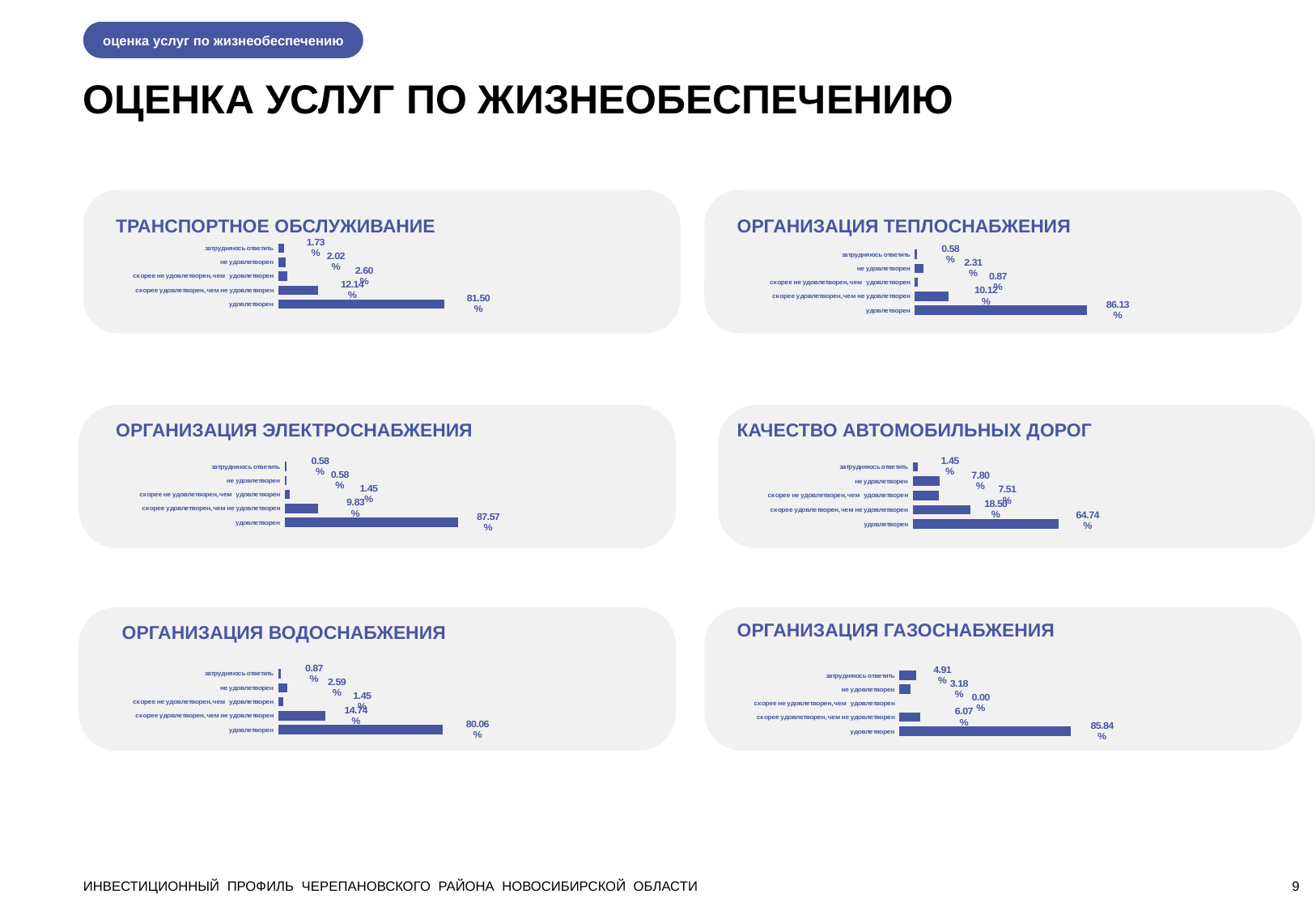
How many charts are shown on the slide? 6 In the chart titled "ОРГАНИЗАЦИЯ ВОДОСНАБЖЕНИЯ", what is the difference between the values for "удовлетворен" and "скорее удовлетворен, чем не удовлетворен"? 65.32 % How many categories does the chart titled "ОРГАНИЗАЦИЯ ТЕПЛОСНАБЖЕНИЯ" show? 5 In the chart titled "ОРГАНИЗАЦИЯ ЭЛЕКТРОСНАБЖЕНИЯ", which category has the highest value? удовлетворен In the chart titled "ОРГАНИЗАЦИЯ ЭЛЕКТРОСНАБЖЕНИЯ", what is the difference between the values for "удовлетворен" and "скорее удовлетворен, чем не удовлетворен"? 77.74 % In the chart titled "ОРГАНИЗАЦИЯ ГАЗОСНАБЖЕНИЯ", what is the value for "скорее не удовлетворен, чем удовлетворен"? 0.00 % In the chart titled "КАЧЕСТВО АВТОМОБИЛЬНЫХ ДОРОГ", which is larger: the value for "не удовлетворен" or the value for "скорее удовлетворен, чем не удовлетворен"? скорее удовлетворен, чем не удовлетворен In the chart titled "ОРГАНИЗАЦИЯ ТЕПЛОСНАБЖЕНИЯ", what is the value for "скорее удовлетворен, чем не удовлетворен"? 10.12 % In the chart titled "КАЧЕСТВО АВТОМОБИЛЬНЫХ ДОРОГ", which category has the lowest value? затрудняюсь ответить What kind of chart is used in the "ТРАНСПОРТНОЕ ОБСЛУЖИВАНИЕ" panel? Bar chart In the chart titled "ТРАНСПОРТНОЕ ОБСЛУЖИВАНИЕ", what is the value for "удовлетворен"? 81.50 % In the chart titled "ОРГАНИЗАЦИЯ ГАЗОСНАБЖЕНИЯ", what is the value for "затрудняюсь ответить"? 4.91 %